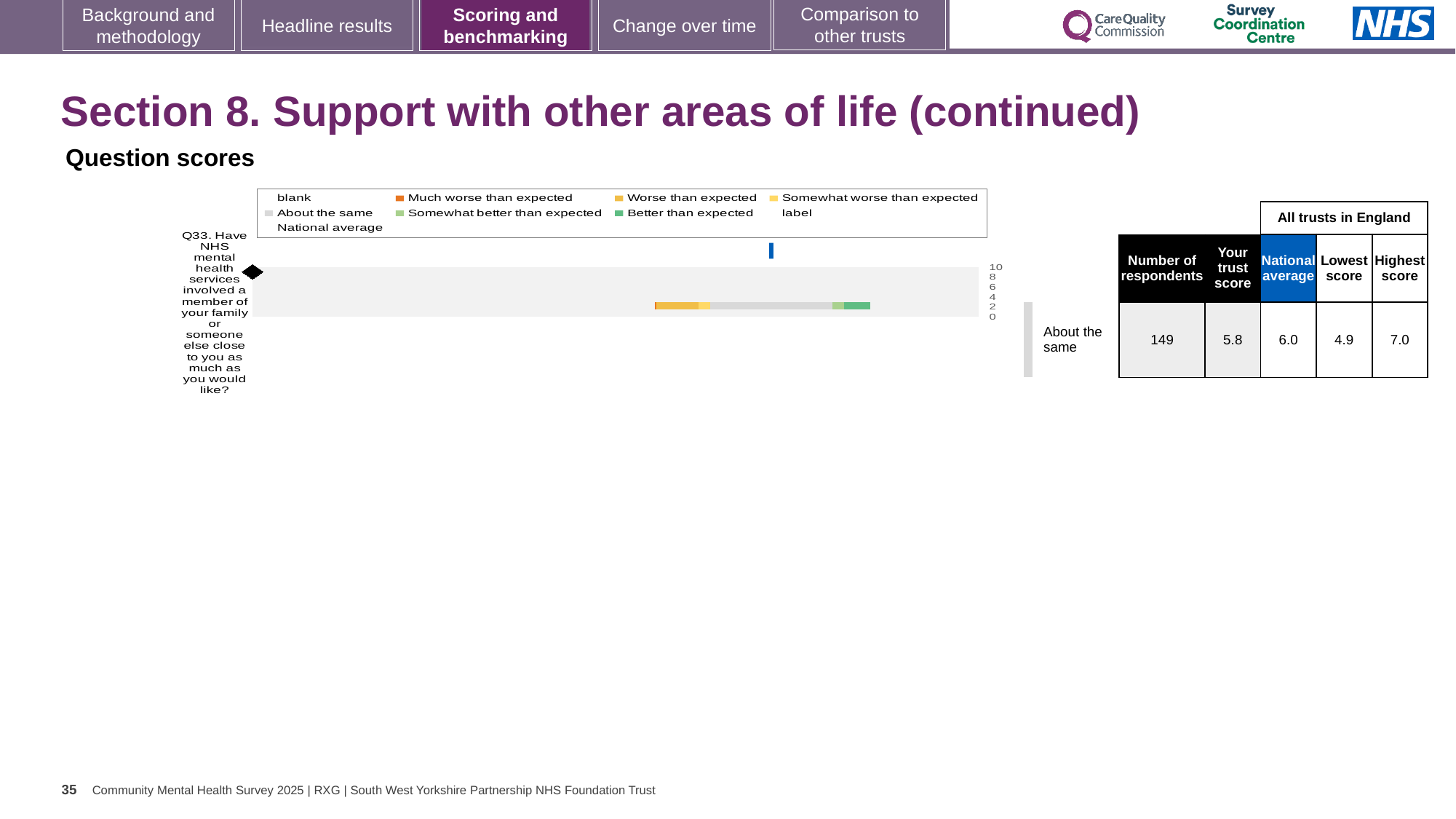
By how much does the national average exceed the trust's score for Q33? 0.2 What is the maximum value shown on the score axis of the chart? 10 What is the lowest score among all trusts in England for Q33? 4.9 What is the difference between the highest and lowest trust scores for Q33? 2.1 What is the highest score among all trusts in England for Q33? 7.0 What type of chart is used to show the Q33 question score? bar chart What is the trust's score for Q33 shown in the table next to the chart? 5.8 Which benchmarking category does the trust fall into for Q33? About the same What is the national average score for Q33? 6.0 Which is larger for Q33, the trust's score or the national average? national average How many respondents answered Q33? 149 How many questions are plotted in the Question scores chart? 1